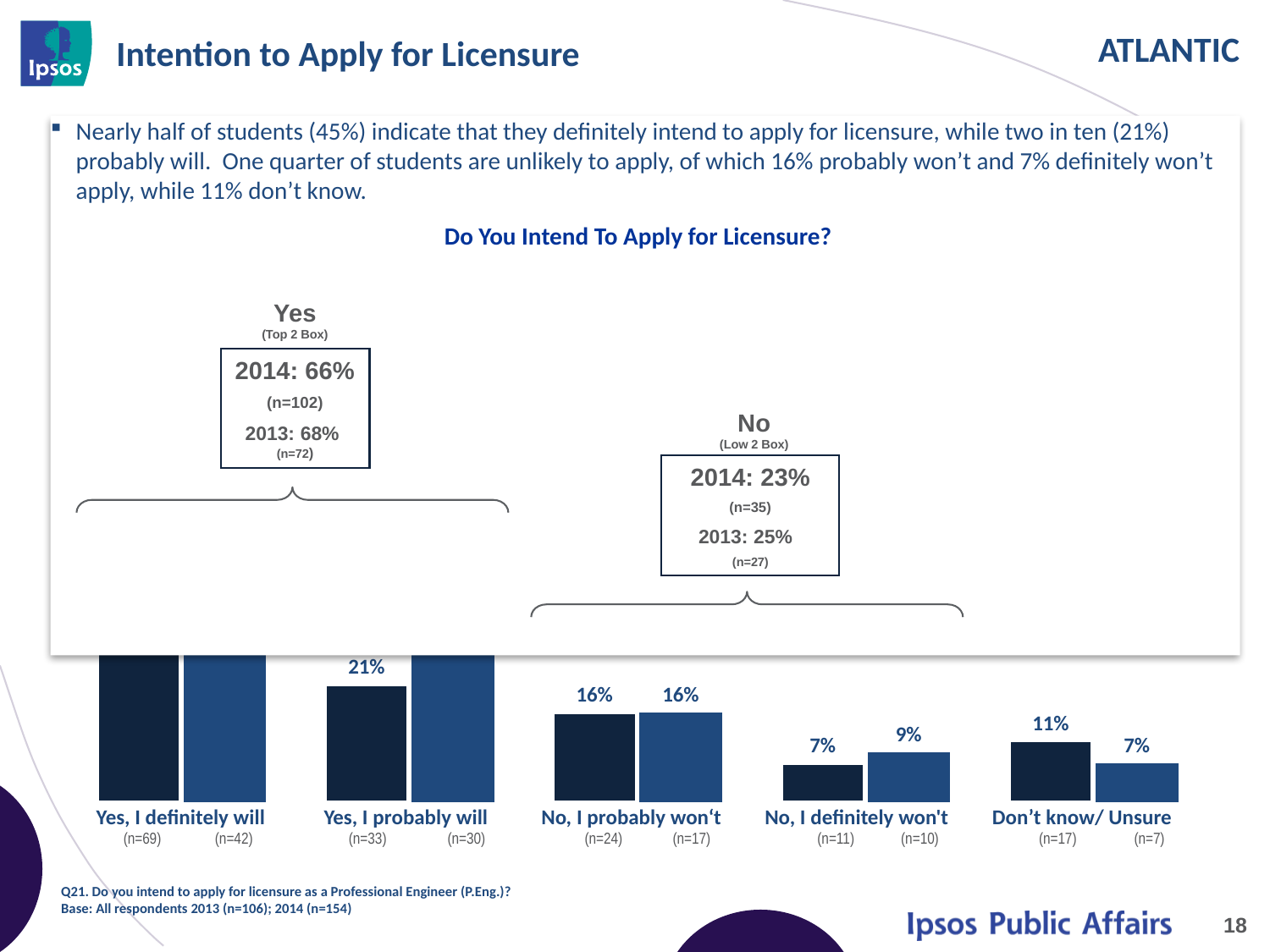
What is the value of the left bar for "No, I probably won't"? 16% According to the "Yes (Top 2 Box)" annotation on the chart, what is the 2014 value? 66% Which response category has the tallest bars in the chart? Yes, I definitely will What is the value of the right bar for "No, I definitely won't"? 9% What is the value of the left bar for "Don't know/ Unsure"? 11% What is the title of the chart? Do You Intend To Apply for Licensure? What is the value of the right bar for "Don't know/ Unsure"? 7% What is the value of the left bar for "Yes, I probably will"? 21% What kind of chart is shown on the slide? Bar chart For "No, I definitely won't", which bar is larger, the left bar or the right bar? The right bar What is the difference between the left bar and the right bar for "Don't know/ Unsure"? 4 percentage points How many response categories are shown along the x axis of the chart? 5